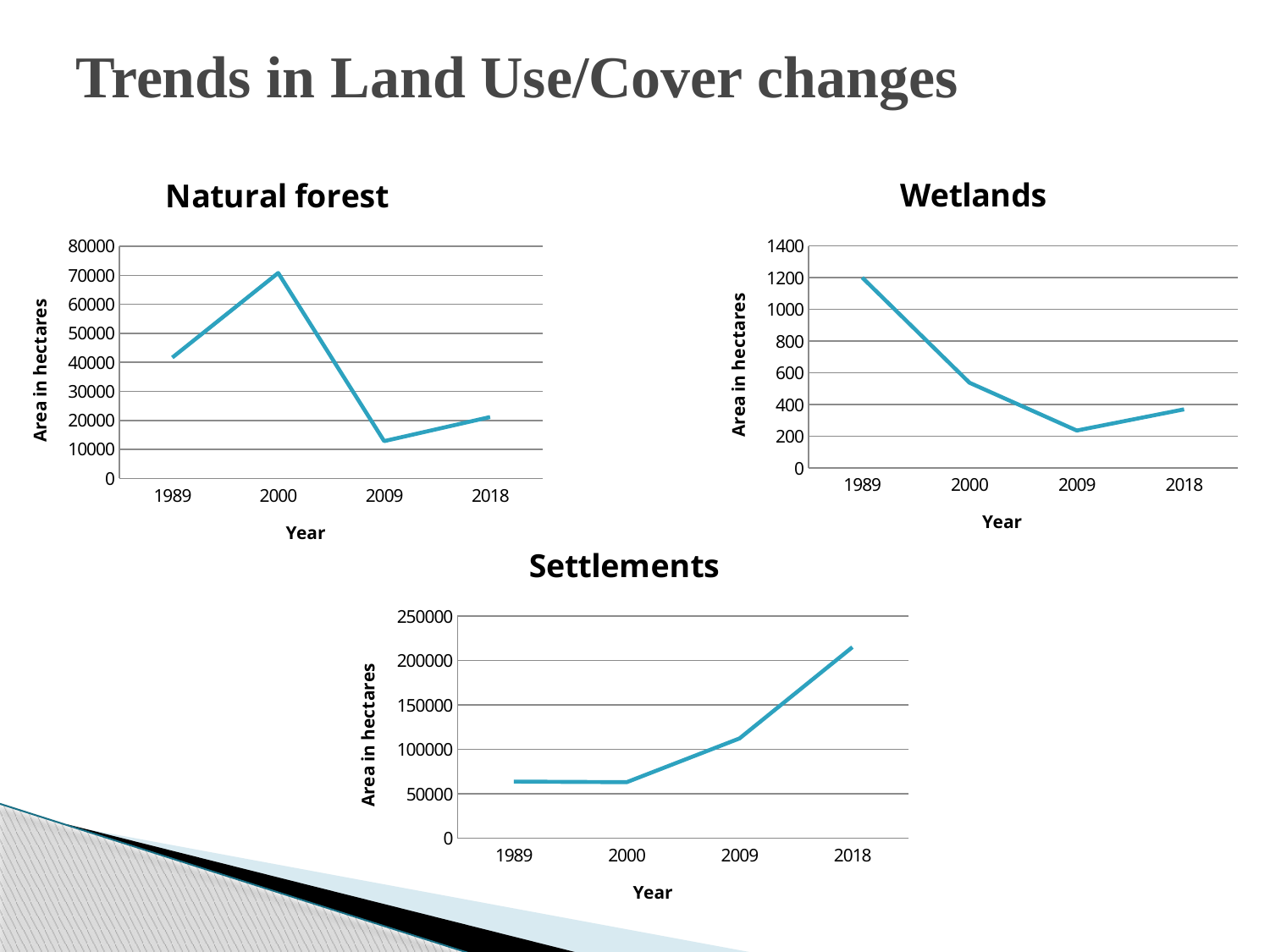
In the Wetlands chart, which is larger, the value for 1989 or the value for 2018? 1989 In the Natural forest chart, which year has the lowest area? 2009 In the Settlements chart, is the value for 2018 greater or less than 200000? greater In the Wetlands chart, which year has the lowest area? 2009 What is the y-axis label of the Wetlands chart? Area in hectares How many years are plotted on the x axis of the Settlements chart? 4 In the Wetlands chart, is the value for 2000 greater or less than 400? greater In the Natural forest chart, is the value for 2000 greater or less than 60000? greater What type of chart is the Natural forest chart? line chart In the Natural forest chart, which year has the highest area? 2000 In the Settlements chart, do the values generally rise or fall from 2000 to 2018? rise